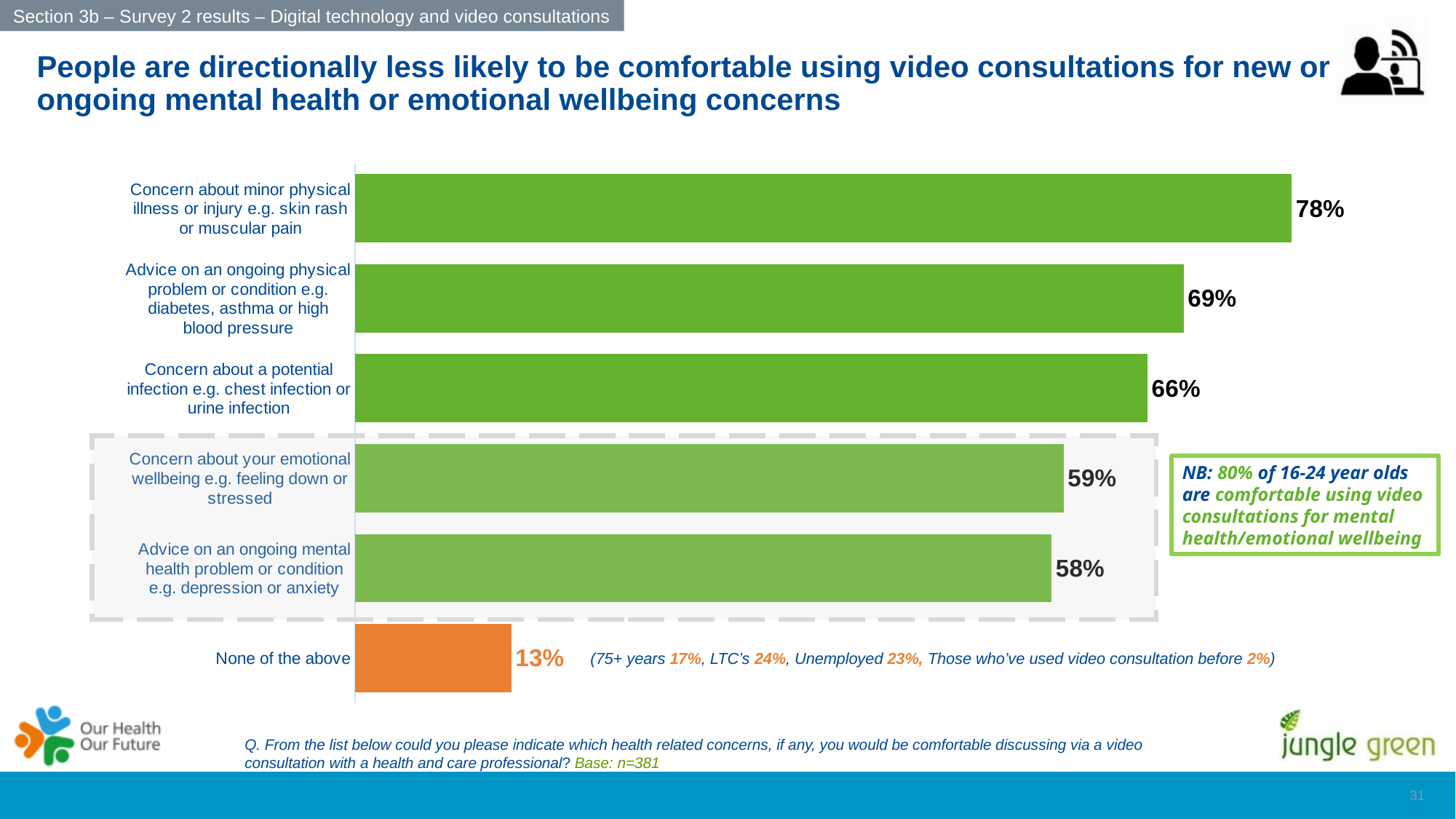
What percentage of people are comfortable using video consultations for concern about minor physical illness or injury e.g. skin rash or muscular pain? 78% What is the difference between the value for 'Concern about your emotional wellbeing' and the value for 'Advice on an ongoing mental health problem or condition'? 1% What kind of chart is shown on the slide? Bar chart Which category has the lowest value? None of the above What is the value for 'Advice on an ongoing mental health problem or condition e.g. depression or anxiety'? 58% Which category has the highest value? Concern about minor physical illness or injury e.g. skin rash or muscular pain What is the difference between the value for 'Concern about minor physical illness or injury' and the value for 'Advice on an ongoing physical problem or condition'? 9% What is the value for 'None of the above'? 13% What is the value for 'Concern about a potential infection e.g. chest infection or urine infection'? 66% What colour is the bar for 'None of the above'? Orange How many categories are shown in the chart? 6 Which is larger: the value for 'Concern about a potential infection' or the value for 'Concern about your emotional wellbeing'? Concern about a potential infection